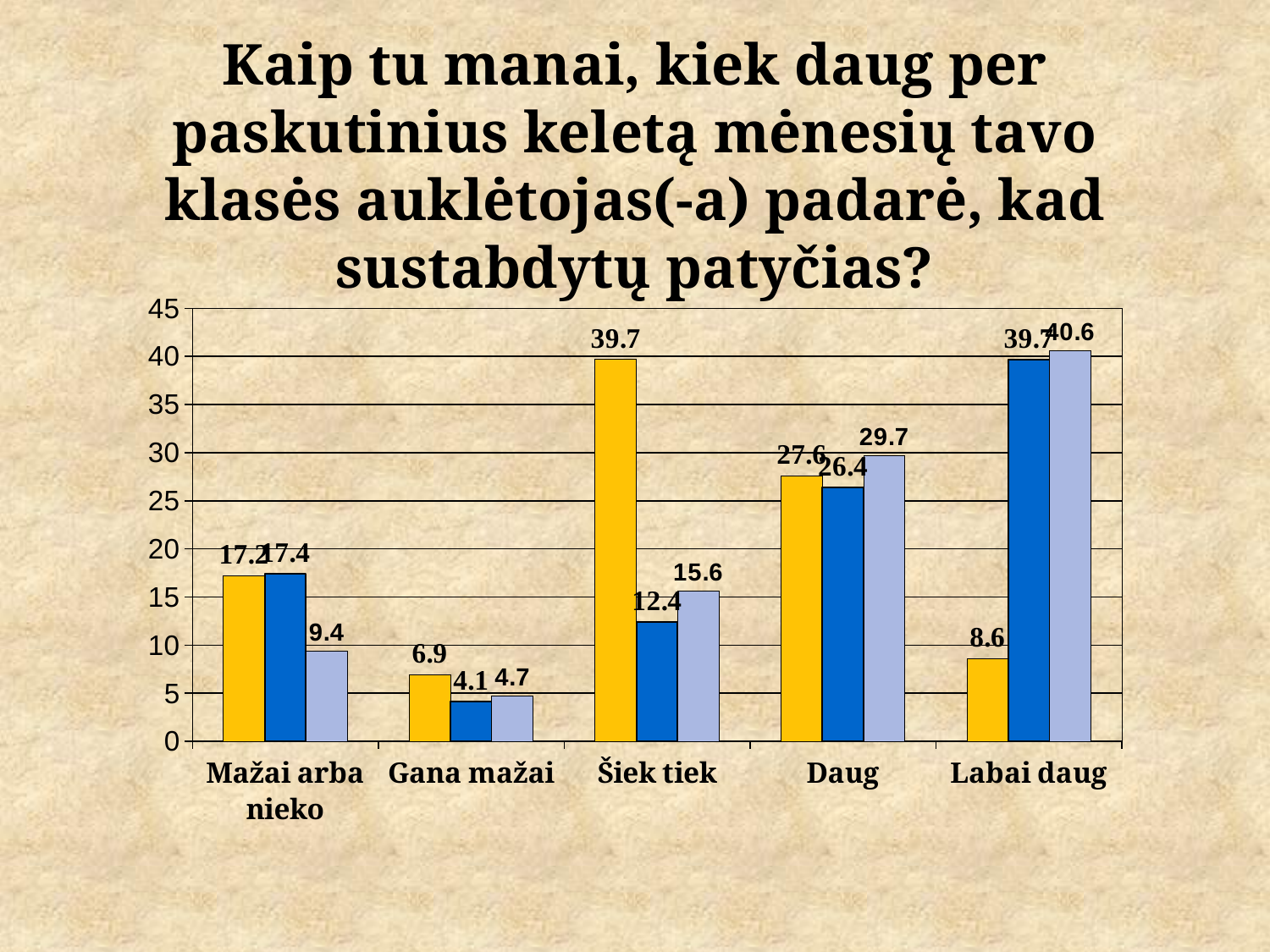
Is the value of the yellow bar for "Daug" greater or less than 25? greater Which category has the highest value for the light blue bars? Labai daug What is the difference between the light blue bar and the dark blue bar for "Šiek tiek"? 3.2 What is the value of the dark blue bar for "Gana mažai"? 4.1 What is the difference between the yellow bar and the dark blue bar for "Šiek tiek"? 27.3 How many categories are shown on the x axis of the chart? 5 What type of chart is shown on the slide? bar chart What is the value of the yellow bar for "Šiek tiek"? 39.7 What is the value of the light blue bar for "Daug"? 29.7 What is the value of the light blue bar for "Labai daug"? 40.6 For "Labai daug", which is larger: the yellow bar or the dark blue bar? the dark blue bar Which category has the lowest value for the yellow bars? Gana mažai